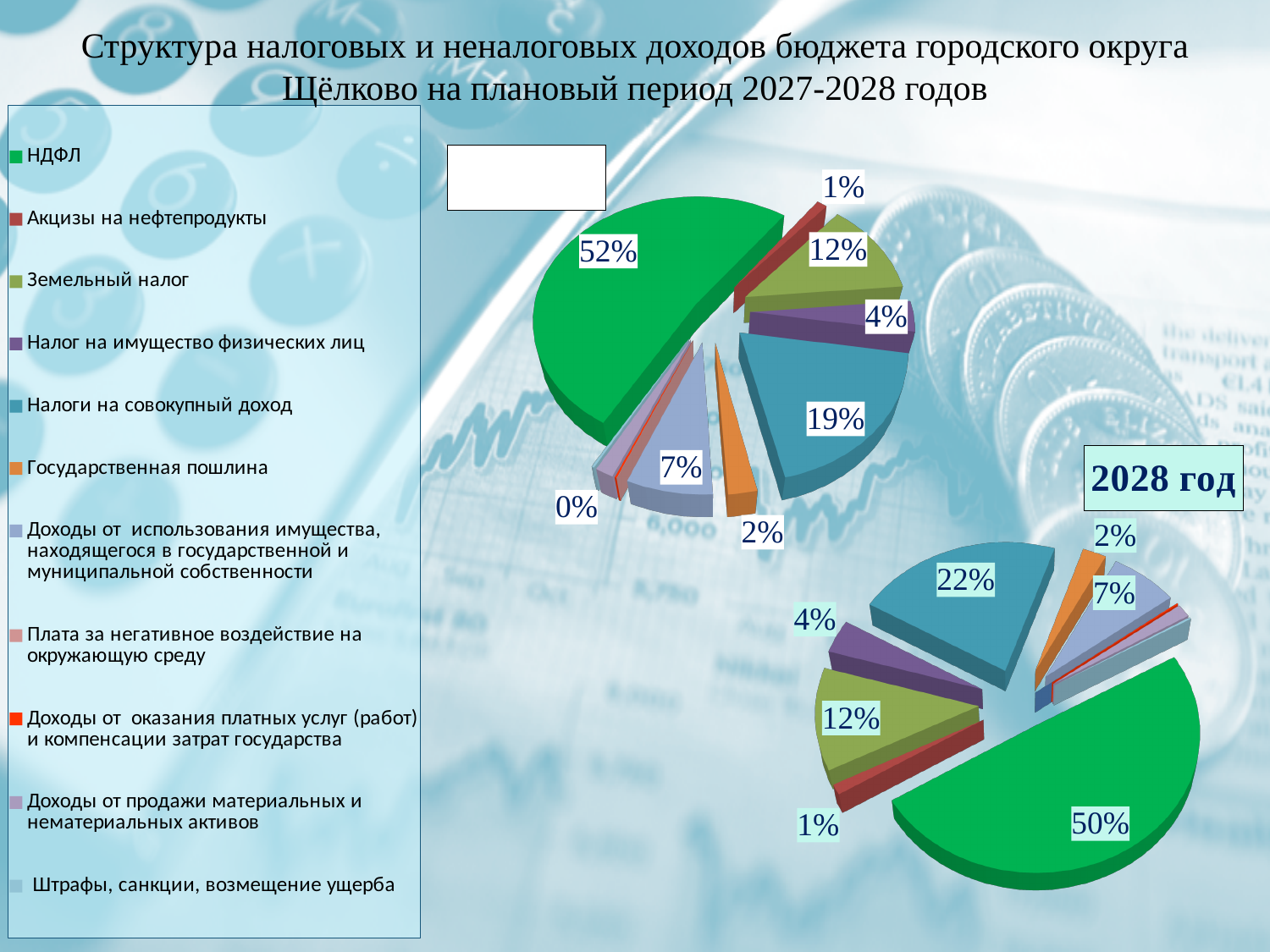
In the pie chart labelled 2028 год, what share does Государственная пошлина have? 2% What type of chart is used on this slide? Pie chart In the pie chart labelled 2028 год, which is larger: Земельный налог or Налог на имущество физических лиц? Земельный налог In the upper-left pie chart, how many percentage points larger is НДФЛ than Налоги на совокупный доход? 33% In the pie chart labelled 2028 год, which category has the largest slice? НДФЛ In the upper-left pie chart, what share do Налоги на совокупный доход have? 19% In the upper-left pie chart, what share does НДФЛ have? 52% In the pie chart labelled 2028 год, how many percentage points larger is НДФЛ than Налоги на совокупный доход? 28% What label is shown next to the lower-right pie chart? 2028 год How many categories does the legend on the left list? 11 In the pie chart labelled 2028 год, what share does НДФЛ have? 50% In the pie chart labelled 2028 год, what share do Налоги на совокупный доход have? 22%